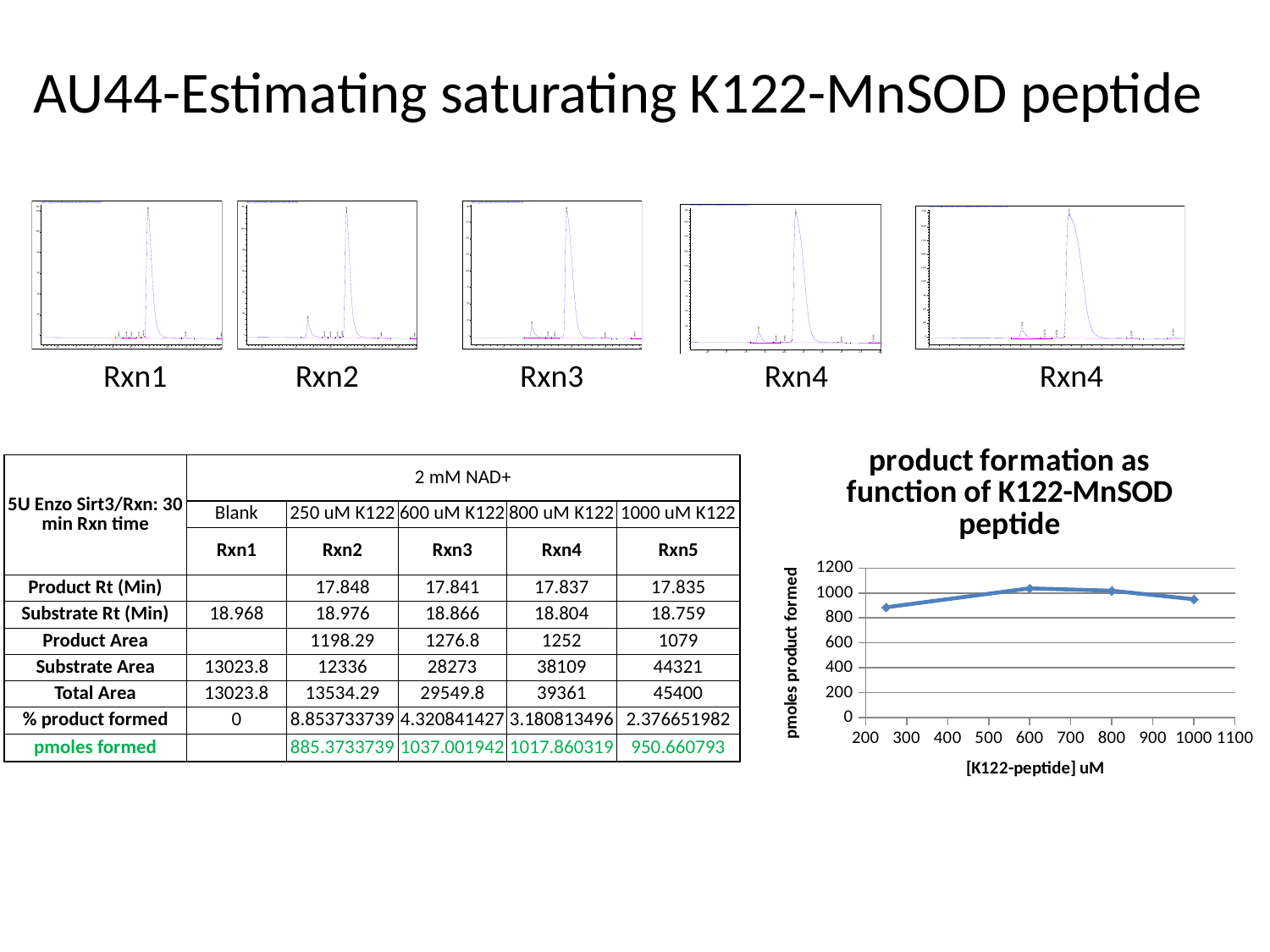
What kind of chart is 'product formation as function of K122-MnSOD peptide'? line chart In the 'product formation as function of K122-MnSOD peptide' chart, is the value at 1000 uM K122-peptide greater or less than 600? greater How many data points are plotted in the 'product formation as function of K122-MnSOD peptide' chart? 4 What is the y-axis title of the 'product formation as function of K122-MnSOD peptide' chart? pmoles product formed In the 'product formation as function of K122-MnSOD peptide' chart, is the value at 250 uM K122-peptide greater or less than 1000? less In the 'product formation as function of K122-MnSOD peptide' chart, is the value at 600 uM K122-peptide greater or less than 1000? greater In the 'product formation as function of K122-MnSOD peptide' chart, which has the larger value: 250 uM or 600 uM K122-peptide? 600 uM In the 'product formation as function of K122-MnSOD peptide' chart, how do the values change as K122-peptide concentration increases from 250 to 1000 uM? rise then fall What is the x-axis title of the 'product formation as function of K122-MnSOD peptide' chart? [K122-peptide] uM